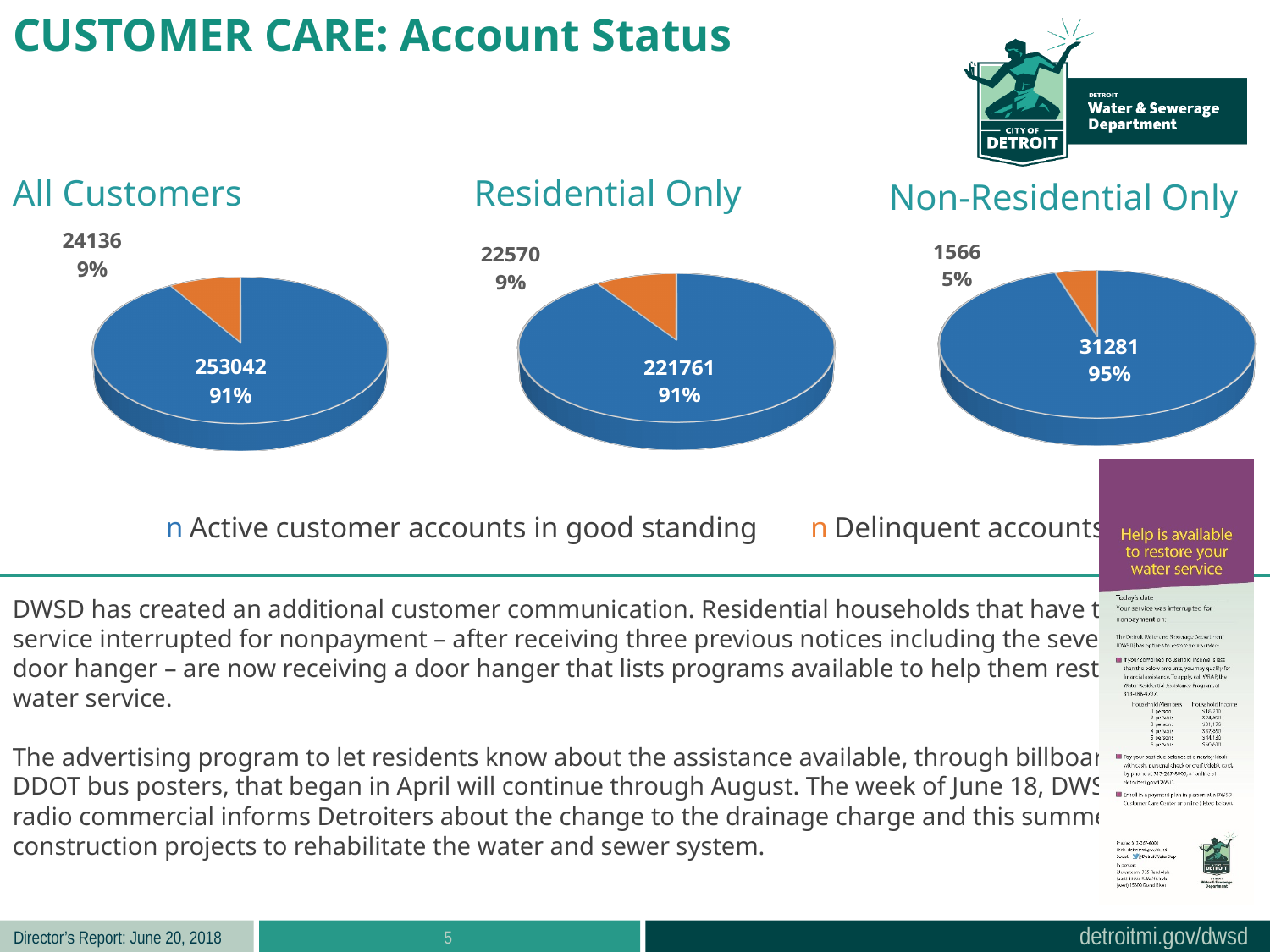
In the Non-Residential Only chart, what percentage of accounts are delinquent? 5% In the All Customers chart, what percentage of accounts are delinquent? 9% In the All Customers chart, how many active customer accounts in good standing are there? 253042 What type of chart is used for the All Customers data? Pie chart How many series does the legend list for the charts? 2 In the Residential Only chart, how many delinquent accounts are there? 22570 In the Non-Residential Only chart, how many active customer accounts in good standing are there? 31281 In the All Customers chart, what is the difference between the number of active accounts in good standing and the number of delinquent accounts? 228906 How many pie charts are shown on the slide? 3 In the Non-Residential Only chart, which slice is larger: active accounts in good standing or delinquent accounts? Active customer accounts in good standing In the Residential Only chart, what share of accounts are active customer accounts in good standing? 91% In the Residential Only chart, what is the total number of accounts shown across both slices? 244331